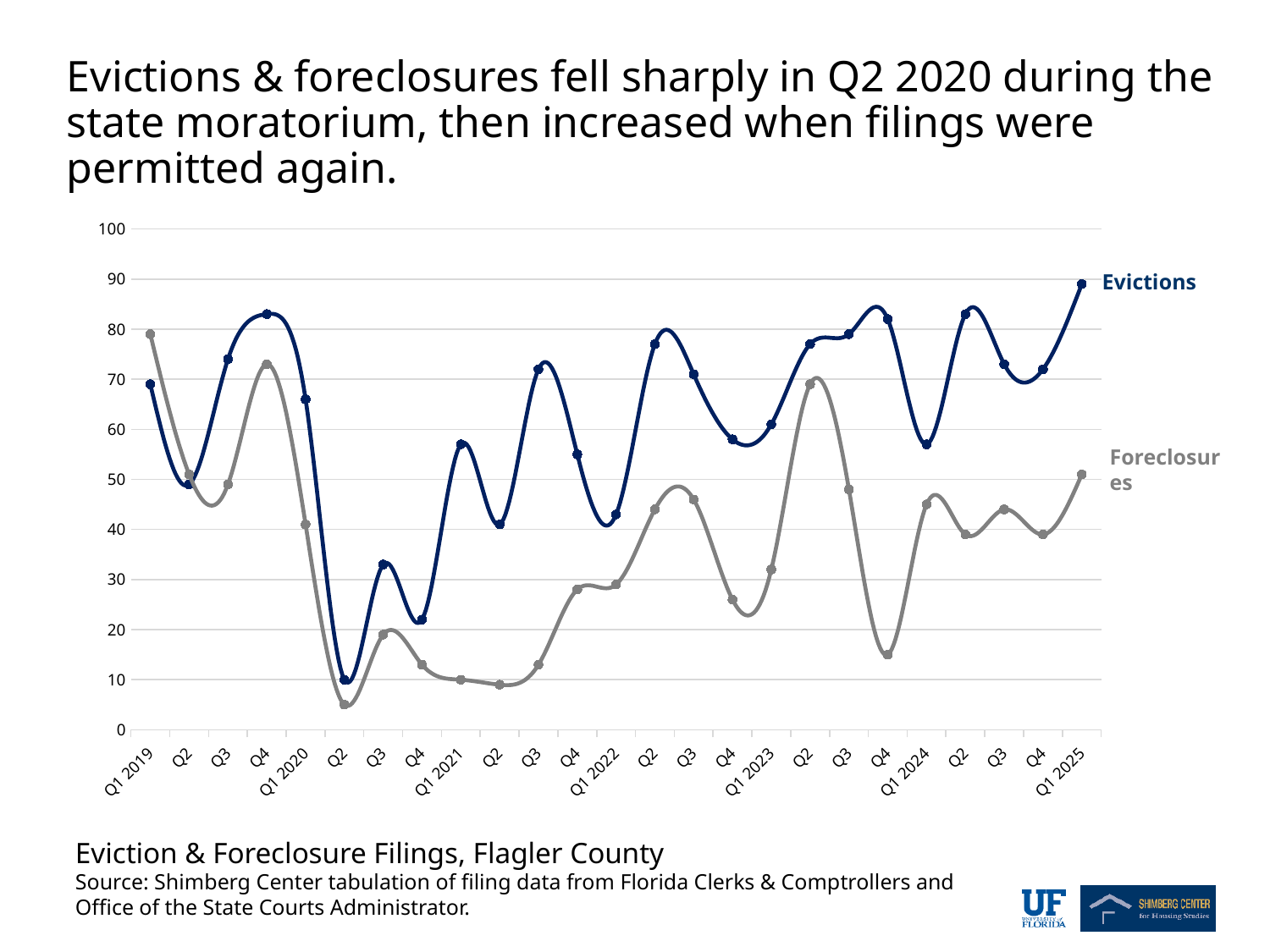
In which quarter are evictions highest? Q1 2025 In which quarter are foreclosures lowest? Q2 2020 How many series does the chart show? 2 In which quarter are evictions lowest? Q2 2020 Which series is drawn in dark blue? Evictions Is the value for evictions in Q1 2025 greater or less than 80? greater In which quarter are foreclosures highest? Q1 2019 What kind of chart is shown on the slide? line chart Is the value for evictions in Q2 2020 greater or less than 20? less How many quarters are plotted along the x axis? 25 In Q1 2019, which is higher: evictions or foreclosures? Foreclosures Is the value for foreclosures in Q1 2019 greater or less than 70? greater